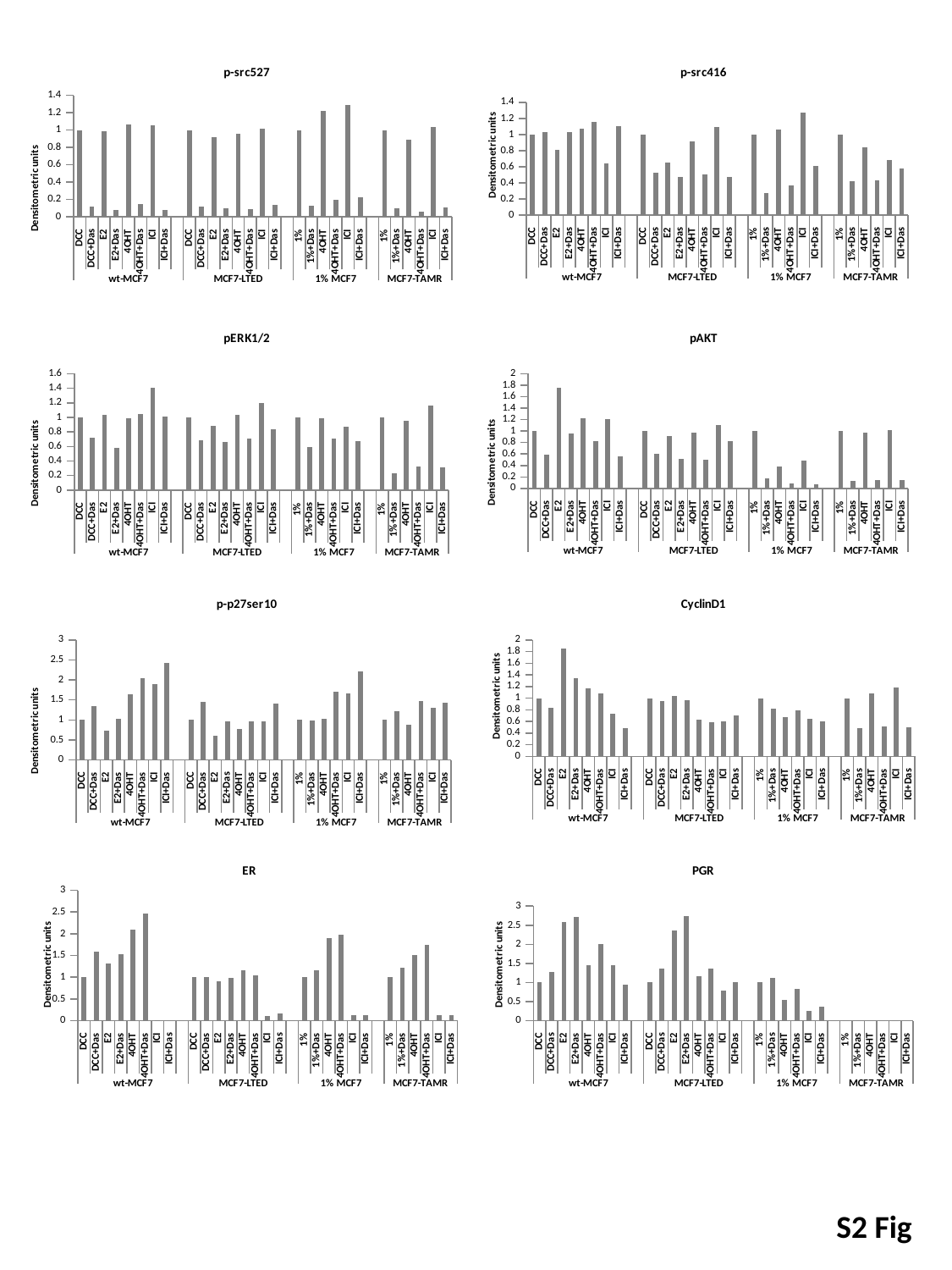
How many charts are shown on the slide? 8 In the ER chart, which bar is the highest? 4OHT+Das in the wt-MCF7 group In the ER chart, is the value for ICI in the wt-MCF7 group greater or less than 0.5? less What is the y-axis label on the ER chart? Densitometric units In the p-src527 chart, is the value for DCC+Das in the wt-MCF7 group greater or less than 0.4? less In the pAKT chart, which bar is the highest? E2 in the wt-MCF7 group In the p-p27ser10 chart, is the value for ICI+Das in the wt-MCF7 group greater or less than 2? greater What kind of chart is the p-src527 chart? bar chart In the CyclinD1 chart, which bar is the highest? E2 in the wt-MCF7 group